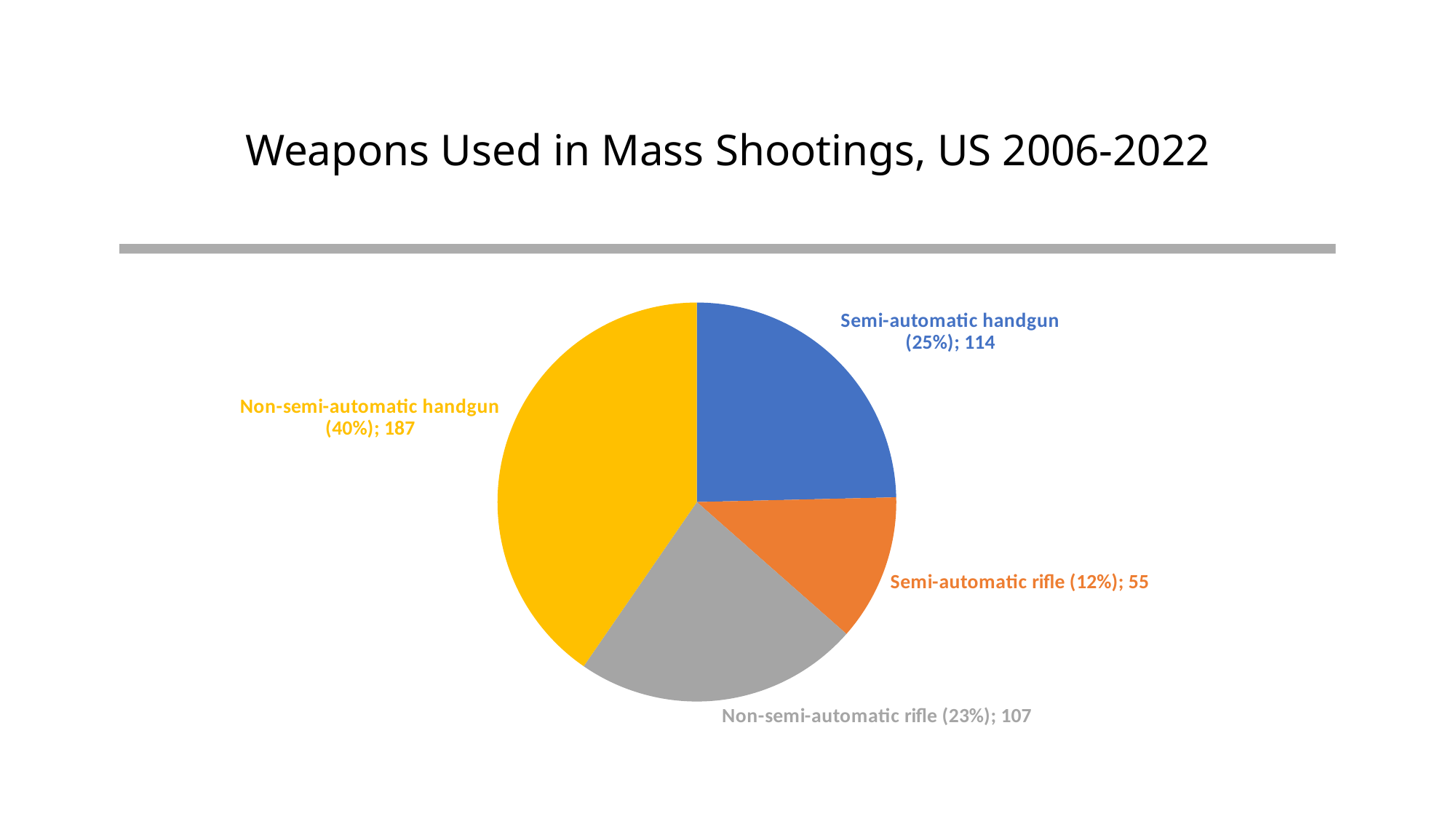
What share of the pie does Non-semi-automatic rifle represent? 23% What is the value for Non-semi-automatic rifle? 107 What is the difference between the values for Non-semi-automatic handgun and Semi-automatic rifle? 132 What share of the pie does Semi-automatic handgun represent? 25% What kind of chart is shown on the slide? pie chart What is the value for Semi-automatic rifle? 55 Which category has the smallest slice? Semi-automatic rifle What is the value for Semi-automatic handgun? 114 How many categories does the pie chart show? 4 Which category has the largest slice? Non-semi-automatic handgun What is the value for Non-semi-automatic handgun? 187 Which is larger, the value for Semi-automatic handgun or Non-semi-automatic rifle? Semi-automatic handgun